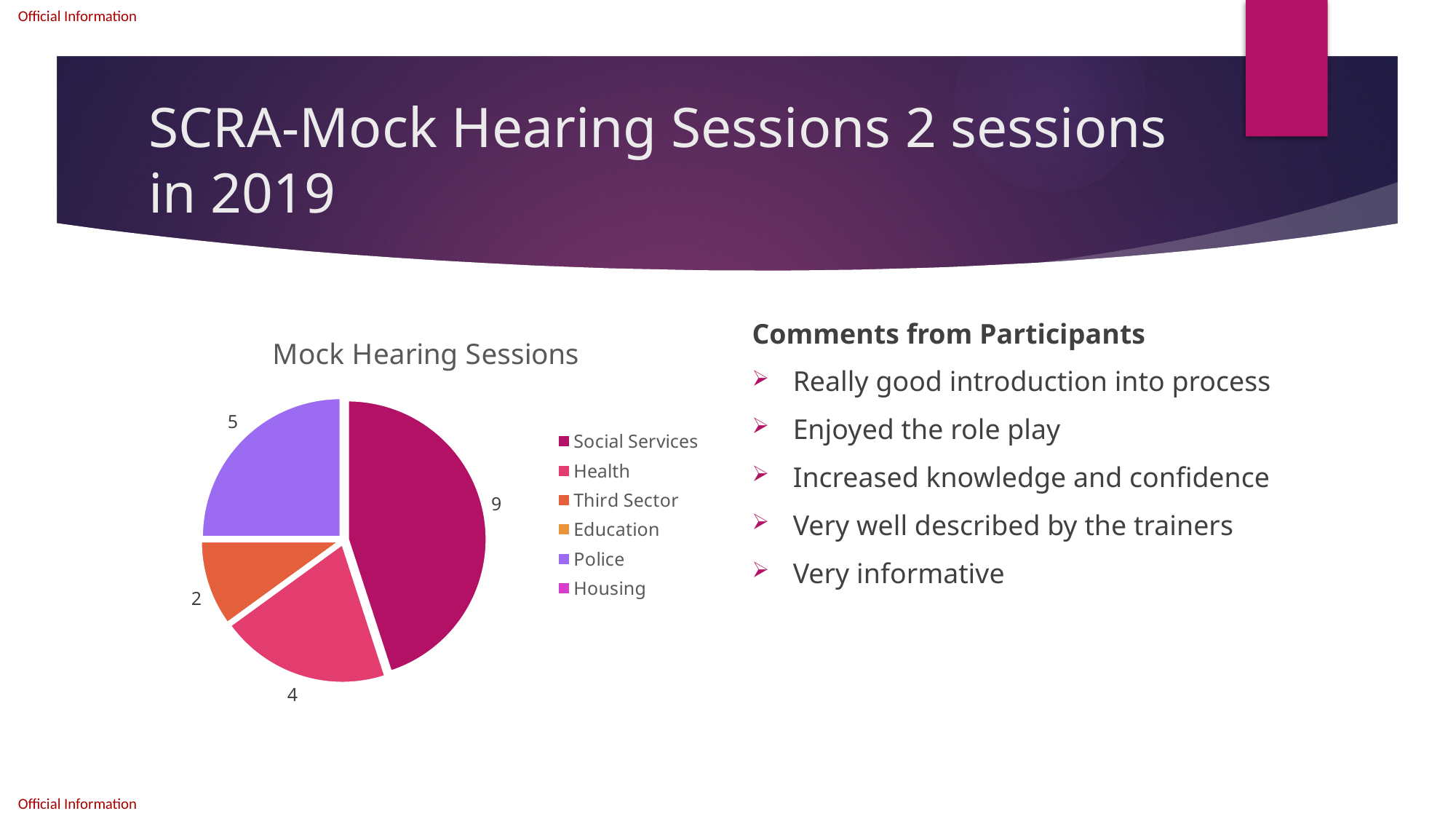
What type of chart is shown on the slide? pie chart What is the difference between the Social Services value and the Police value? 4 What is the value for Health in the Mock Hearing Sessions pie chart? 4 Which labelled slice is the smallest in the Mock Hearing Sessions pie chart? Third Sector What is the title of the chart? Mock Hearing Sessions What is the value for Third Sector in the Mock Hearing Sessions pie chart? 2 What is the value for Social Services in the Mock Hearing Sessions pie chart? 9 How many entries does the legend of the pie chart list? 6 Which category has the largest slice in the Mock Hearing Sessions pie chart? Social Services What is the value for Police in the Mock Hearing Sessions pie chart? 5 How many slices with data labels are visible in the pie chart? 4 Which is larger, the Health slice or the Police slice? Police